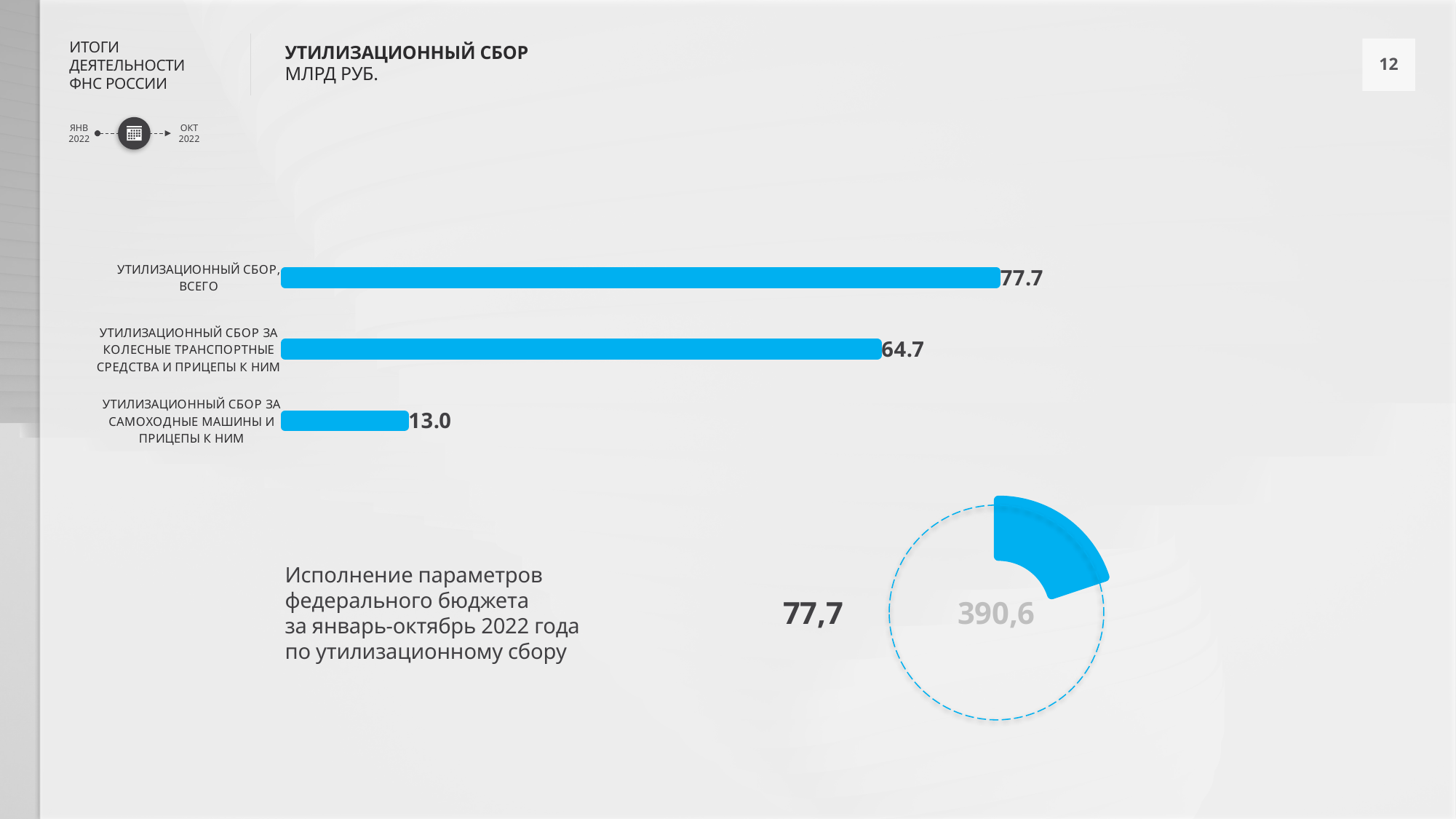
In the bar chart, what is the value for УТИЛИЗАЦИОННЫЙ СБОР, ВСЕГО? 77.7 In the bar chart, which category has the lowest value? УТИЛИЗАЦИОННЫЙ СБОР ЗА САМОХОДНЫЕ МАШИНЫ И ПРИЦЕПЫ К НИМ In the bar chart, which category has the highest value? УТИЛИЗАЦИОННЫЙ СБОР, ВСЕГО In the pie chart at the bottom right of the slide, what value is shown for the highlighted slice? 77,7 How many categories does the bar chart show? 3 What unit is stated under the title УТИЛИЗАЦИОННЫЙ СБОР at the top of the slide? МЛРД РУБ. In the bar chart, what is the value for УТИЛИЗАЦИОННЫЙ СБОР ЗА КОЛЕСНЫЕ ТРАНСПОРТНЫЕ СРЕДСТВА И ПРИЦЕПЫ К НИМ? 64.7 In the bar chart, what is the difference between the value for УТИЛИЗАЦИОННЫЙ СБОР ЗА КОЛЕСНЫЕ ТРАНСПОРТНЫЕ СРЕДСТВА И ПРИЦЕПЫ К НИМ and the value for УТИЛИЗАЦИОННЫЙ СБОР ЗА САМОХОДНЫЕ МАШИНЫ И ПРИЦЕПЫ К НИМ? 51.7 In the bar chart, what is the difference between the value for УТИЛИЗАЦИОННЫЙ СБОР, ВСЕГО and the value for УТИЛИЗАЦИОННЫЙ СБОР ЗА КОЛЕСНЫЕ ТРАНСПОРТНЫЕ СРЕДСТВА И ПРИЦЕПЫ К НИМ? 13.0 In the bar chart, which is larger: the value for УТИЛИЗАЦИОННЫЙ СБОР ЗА КОЛЕСНЫЕ ТРАНСПОРТНЫЕ СРЕДСТВА И ПРИЦЕПЫ К НИМ or the value for УТИЛИЗАЦИОННЫЙ СБОР ЗА САМОХОДНЫЕ МАШИНЫ И ПРИЦЕПЫ К НИМ? УТИЛИЗАЦИОННЫЙ СБОР ЗА КОЛЕСНЫЕ ТРАНСПОРТНЫЕ СРЕДСТВА И ПРИЦЕПЫ К НИМ In the bar chart, what is the value for УТИЛИЗАЦИОННЫЙ СБОР ЗА САМОХОДНЫЕ МАШИНЫ И ПРИЦЕПЫ К НИМ? 13.0 What kind of chart is the chart at the top of the slide? Bar chart